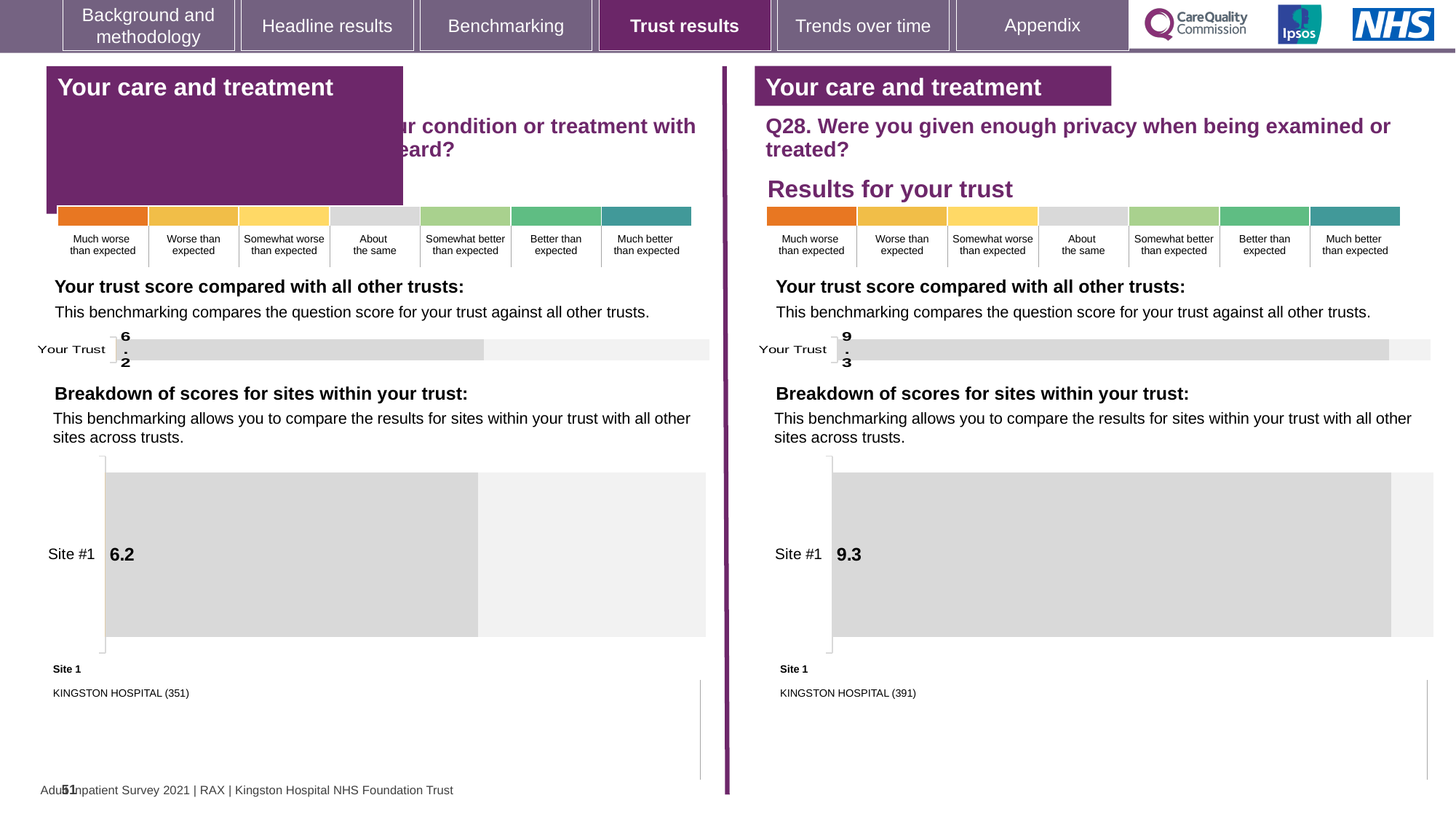
On the right-hand side of the slide (Q28), what is the score shown for Your Trust in the 'Your trust score compared with all other trusts' chart? 9.3 What is the difference between the Site #1 score on the right-hand (Q28) chart and the Site #1 score on the left-hand chart? 3.1 What kind of chart is used to show the Site #1 score on the right-hand side (Q28)? Bar chart What kind of chart is used to show the Your Trust score on the left-hand side? Bar chart Which site is listed as Site 1 beneath the left-hand breakdown chart? KINGSTON HOSPITAL (351) On the left-hand side of the slide, what score is shown for Site #1 in the 'Breakdown of scores for sites within your trust' chart? 6.2 On the right-hand side of the slide (Q28), what score is shown for Site #1 in the 'Breakdown of scores for sites within your trust' chart? 9.3 How many sites are shown in the 'Breakdown of scores for sites within your trust' chart on the right-hand side (Q28)? 1 Which is larger: the Site #1 score on the left-hand chart or the Site #1 score on the right-hand (Q28) chart? The right-hand (Q28) chart Which site is listed as Site 1 beneath the right-hand (Q28) breakdown chart? KINGSTON HOSPITAL (391) On the left-hand side of the slide, what is the score shown for Your Trust in the 'Your trust score compared with all other trusts' chart? 6.2 How many sites are shown in the 'Breakdown of scores for sites within your trust' chart on the left-hand side? 1